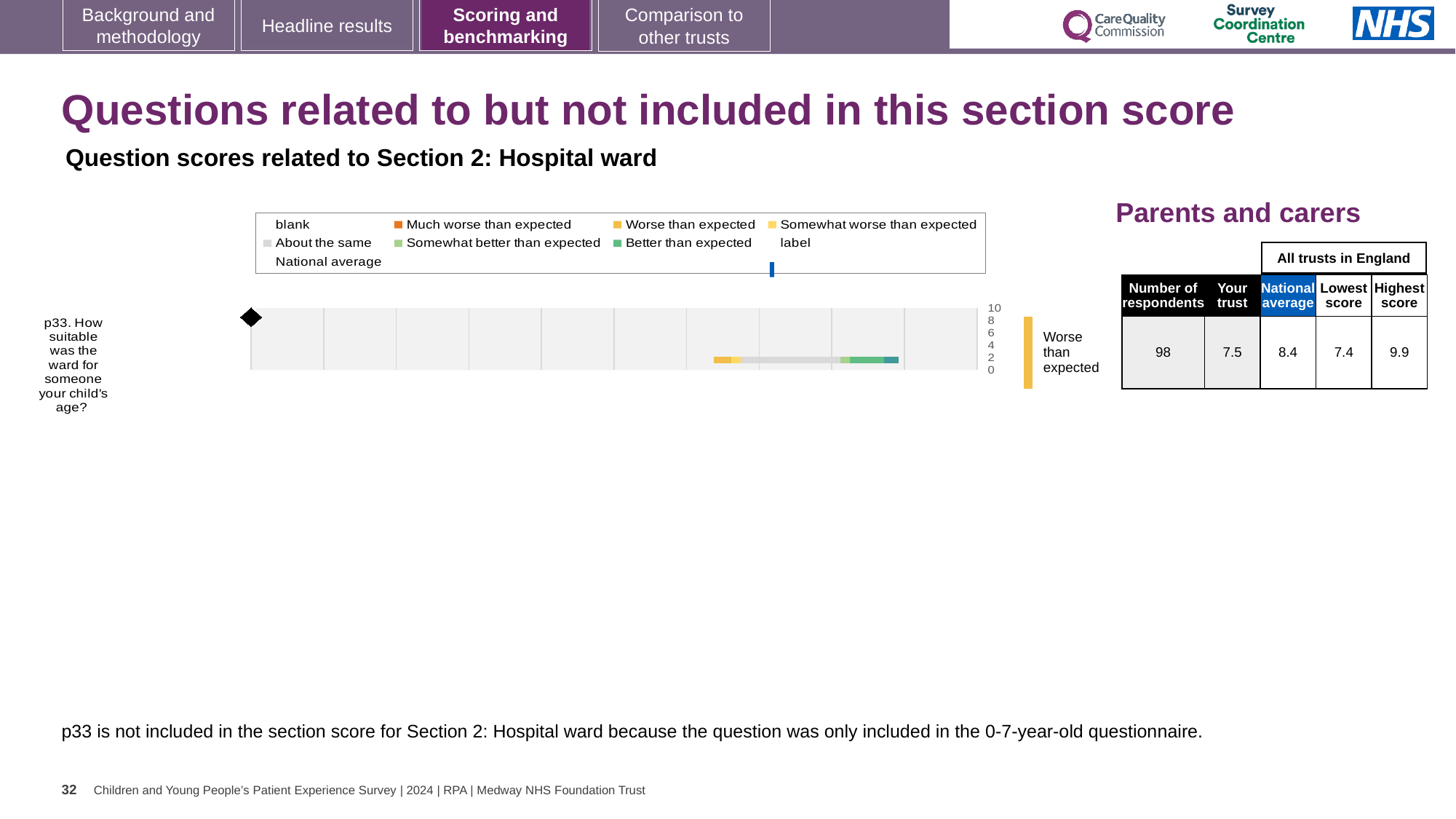
What kind of chart is used to show the p33 question score? bar chart What is the 'Your trust' score for p33? 7.5 What is the national average score for p33? 8.4 How many questions are plotted in the chart? 1 What is the difference between the highest and lowest scores for p33 across all trusts in England? 2.5 How many respondents answered p33? 98 What is the lowest score among all trusts in England for p33? 7.4 What is the difference between the national average and the 'Your trust' score for p33? 0.9 Which question is plotted in the chart? p33. How suitable was the ward for someone your child's age? What benchmark category label is shown next to the chart for p33? Worse than expected What is the highest score among all trusts in England for p33? 9.9 Which is larger for p33, the 'Your trust' score or the national average? National average